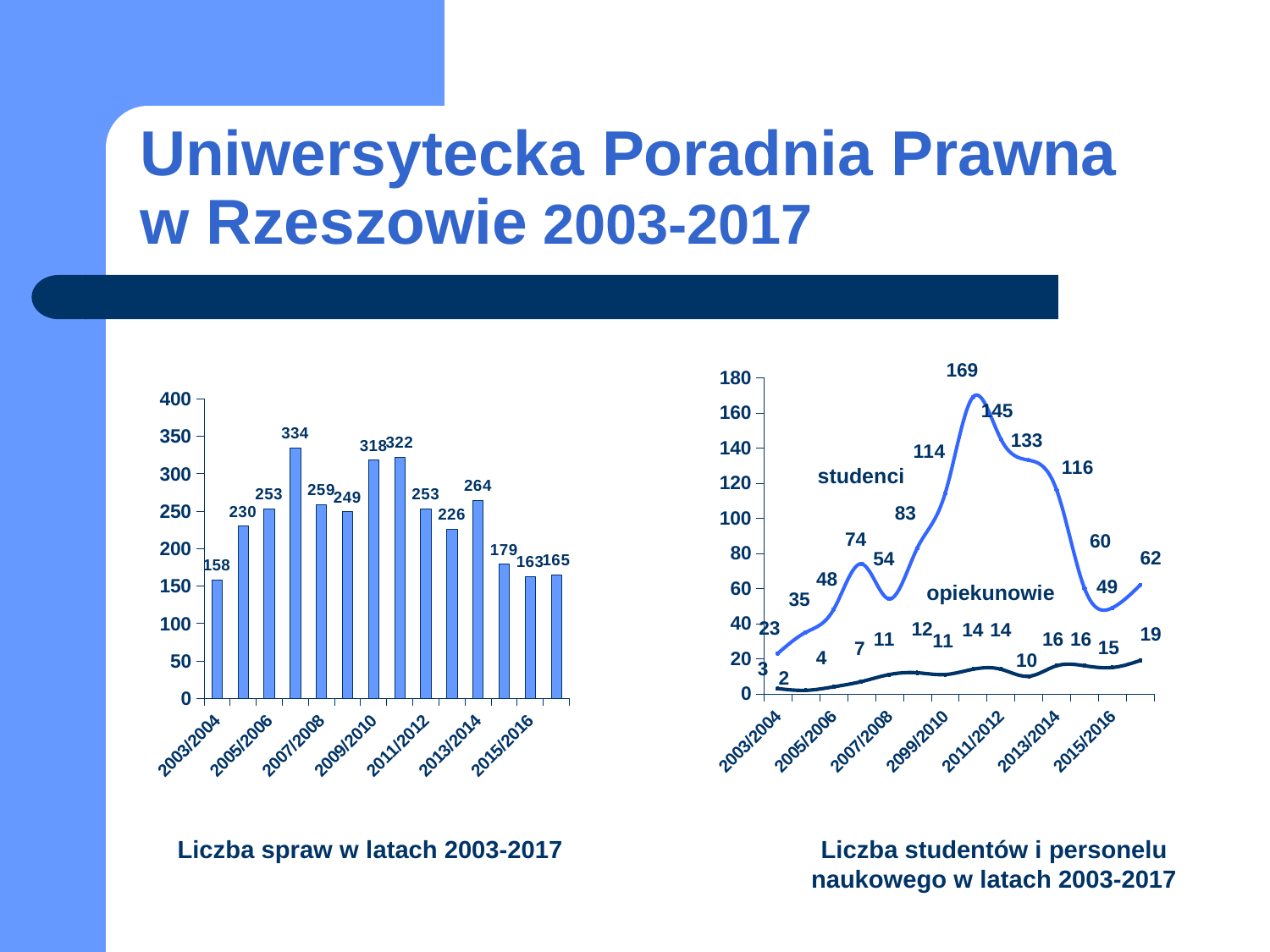
In the left chart 'Liczba spraw w latach 2003-2017', what is the value for 2003/2004? 158 In the left chart 'Liczba spraw w latach 2003-2017', what is the value for 2015/2016? 163 In the right chart 'Liczba studentów i personelu naukowego w latach 2003-2017', how many series are plotted? 2 What kind of chart is the right chart, 'Liczba studentów i personelu naukowego w latach 2003-2017'? line chart What kind of chart is the left chart, 'Liczba spraw w latach 2003-2017'? bar chart In the left chart 'Liczba spraw w latach 2003-2017', what is the highest value shown? 334 In the left chart 'Liczba spraw w latach 2003-2017', what is the lowest value shown? 158 In the right chart 'Liczba studentów i personelu naukowego w latach 2003-2017', what is the value of 'opiekunowie' for 2003/2004? 3 In the right chart 'Liczba studentów i personelu naukowego w latach 2003-2017', what is the highest value of the 'studenci' series? 169 In the left chart 'Liczba spraw w latach 2003-2017', how many bars are plotted? 14 In the left chart 'Liczba spraw w latach 2003-2017', what is the difference between the highest value (334) and the lowest value (158)? 176 In the right chart 'Liczba studentów i personelu naukowego w latach 2003-2017', which series has the larger value for 2003/2004, 'studenci' or 'opiekunowie'? studenci